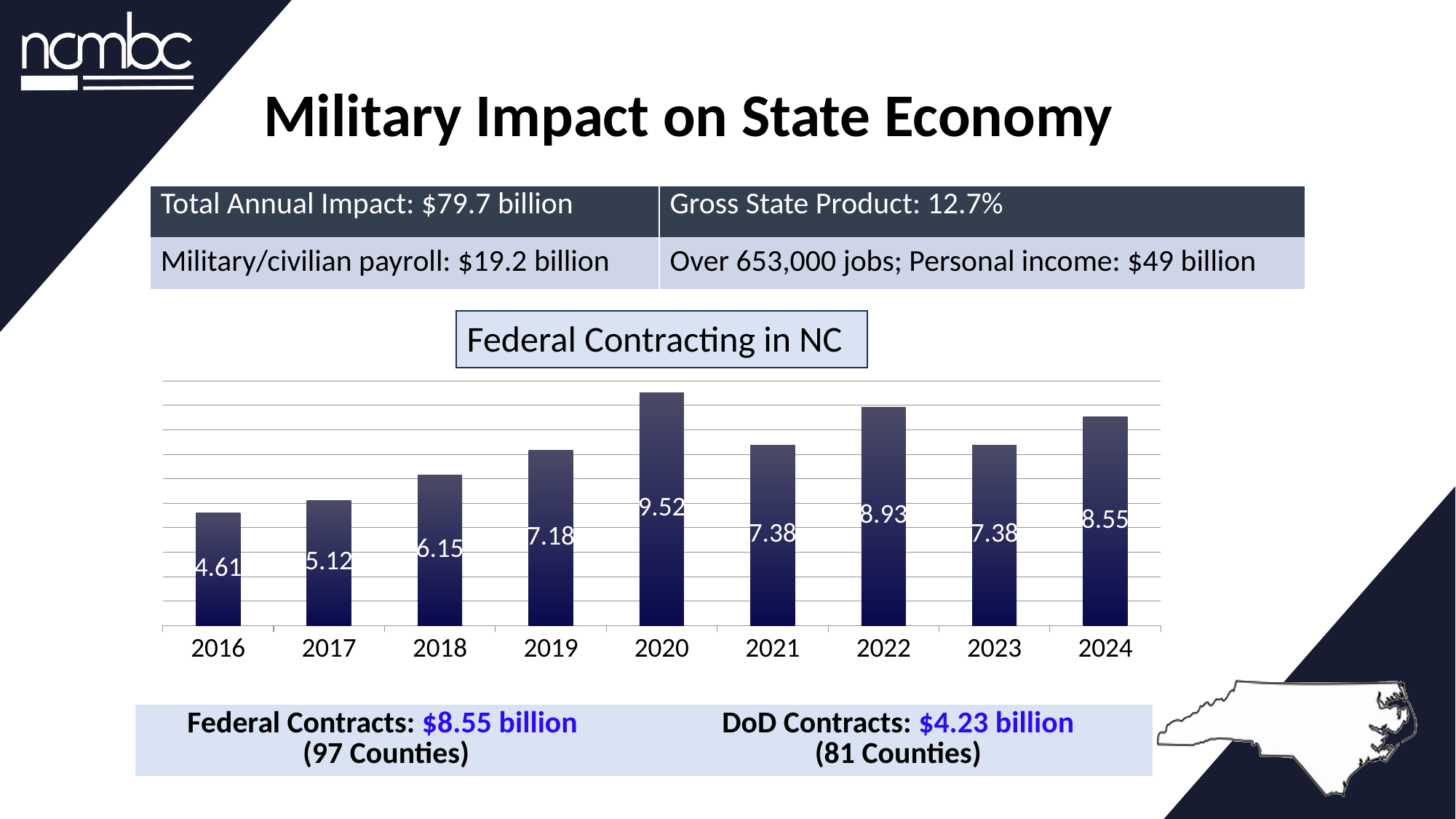
What kind of chart is the Federal Contracting in NC chart? bar chart What is the value for 2016 in the Federal Contracting in NC chart? 4.61 Which is larger in the Federal Contracting in NC chart, the value for 2019 or the value for 2022? 2022 How many years are shown in the Federal Contracting in NC chart? 9 What is the difference between the 2020 and 2016 values in the Federal Contracting in NC chart? 4.91 What is the difference between the 2022 and 2023 values in the Federal Contracting in NC chart? 1.55 What is the value for 2024 in the Federal Contracting in NC chart? 8.55 Which year has the highest value in the Federal Contracting in NC chart? 2020 What is the title of the chart on the slide? Federal Contracting in NC What is the value for 2020 in the Federal Contracting in NC chart? 9.52 Which year has the lowest value in the Federal Contracting in NC chart? 2016 Do the values in the Federal Contracting in NC chart rise or fall from 2016 to 2020? rise